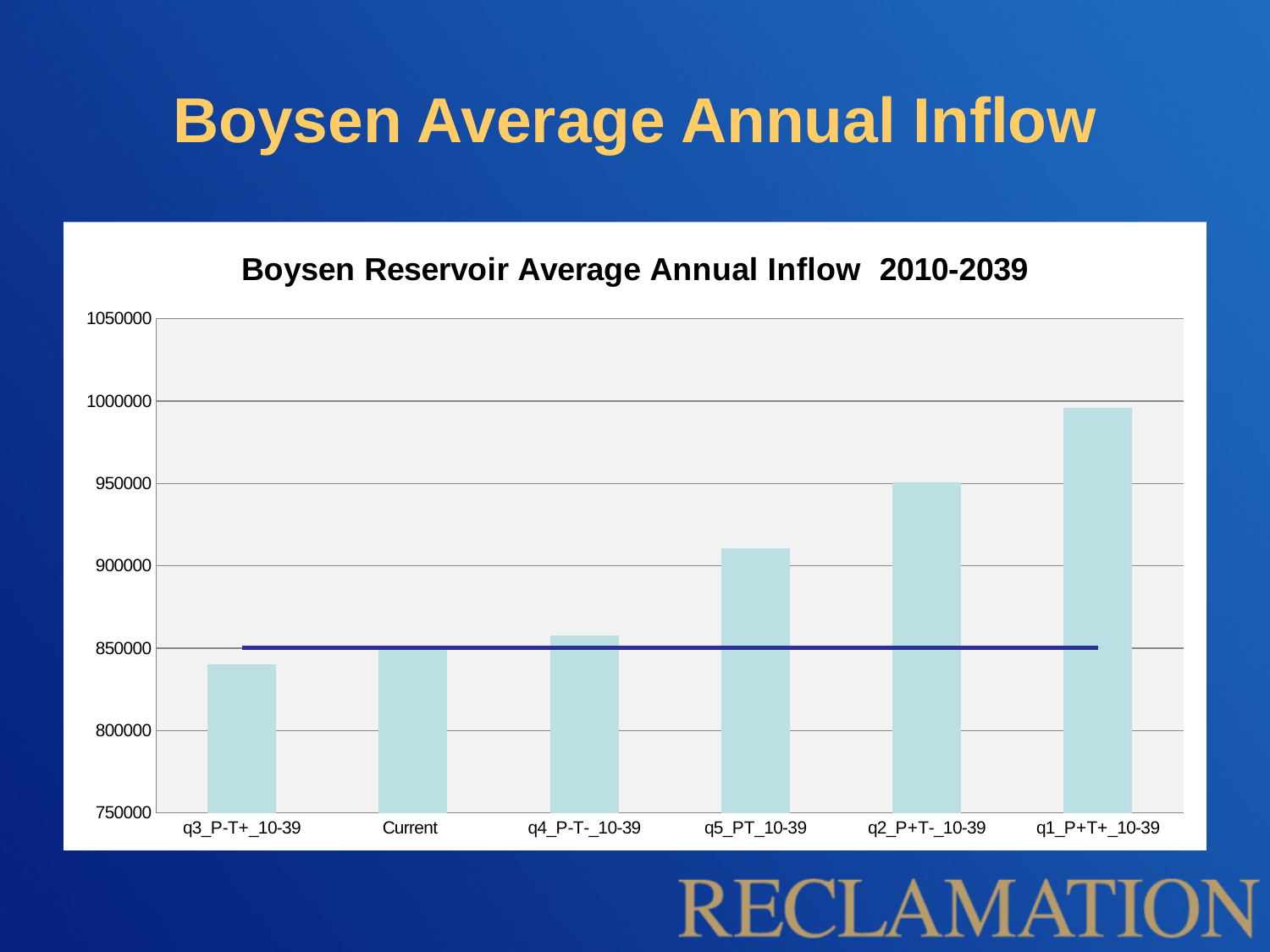
Do the bar values generally rise or fall from left to right along the x axis? rise Which is larger, the value for q5_PT_10-39 or the value for Current? q5_PT_10-39 What is the title of the chart? Boysen Reservoir Average Annual Inflow 2010-2039 Which category has the highest average annual inflow? q1_P+T+_10-39 Is the value for q1_P+T+_10-39 greater or less than 950000? greater How many categories are shown on the x axis of the chart? 6 What type of chart is shown on the slide? bar chart Is the value for q3_P-T+_10-39 greater or less than 850000? less Is the value for q5_PT_10-39 greater or less than 900000? greater Which category has the lowest average annual inflow? q3_P-T+_10-39 At what y-axis value is the dark horizontal reference line drawn across the chart? 850000